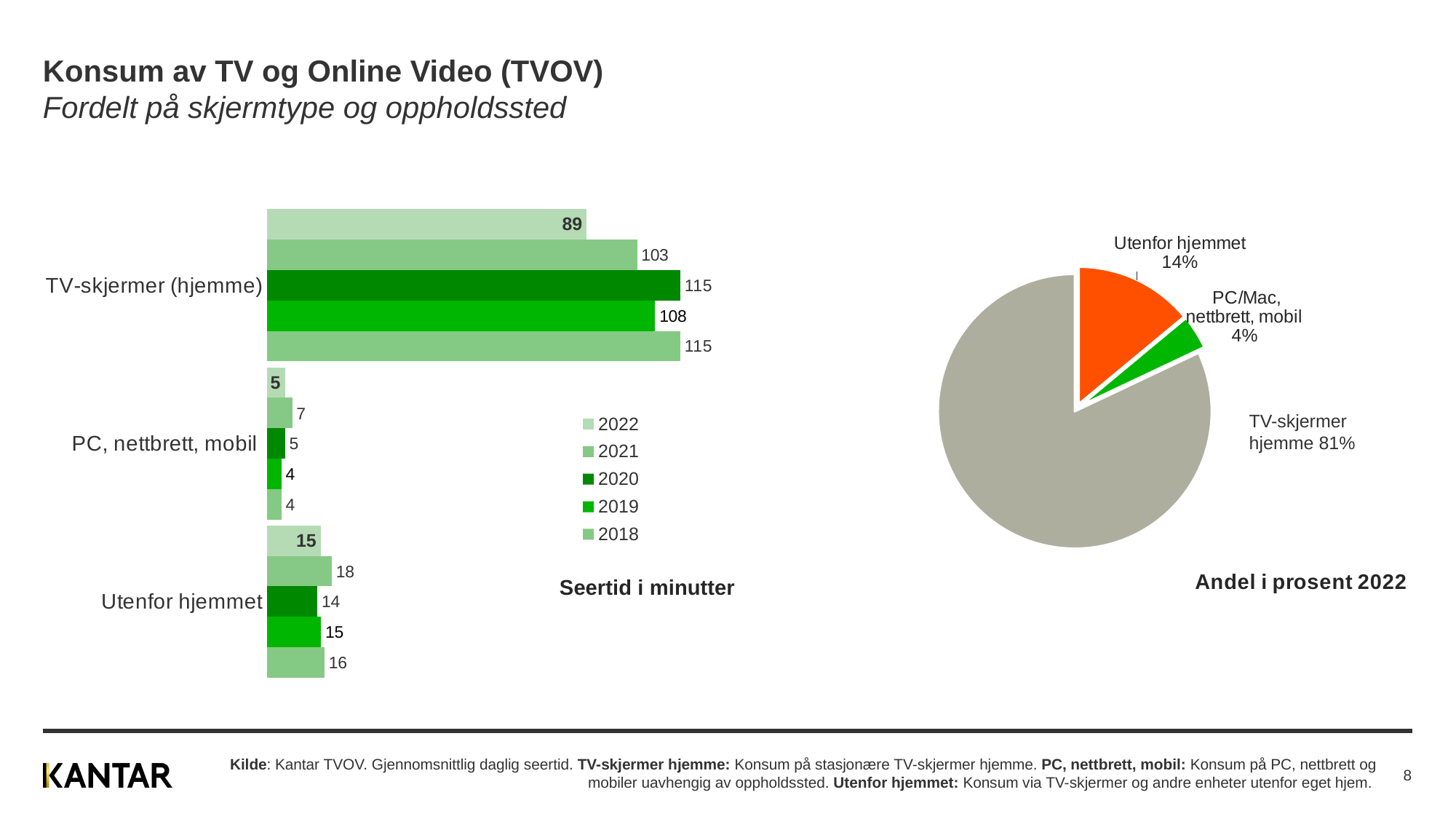
How many categories are shown in the bar chart 'Seertid i minutter'? 3 In the bar chart 'Seertid i minutter', what is the value for PC, nettbrett, mobil in 2019? 4 In the bar chart 'Seertid i minutter', which year has the lowest value for TV-skjermer (hjemme)? 2022 In the bar chart 'Seertid i minutter', which year has the highest value for Utenfor hjemmet? 2021 In the bar chart 'Seertid i minutter', what is the value for Utenfor hjemmet in 2021? 18 How many series does the legend of the bar chart 'Seertid i minutter' list? 5 In the bar chart 'Seertid i minutter', what is the difference between the 2021 and 2022 values for TV-skjermer (hjemme)? 14 In the bar chart 'Seertid i minutter', what is the value for TV-skjermer (hjemme) in 2022? 89 What kind of chart is the chart titled 'Andel i prosent 2022'? Pie chart In the pie chart 'Andel i prosent 2022', what share does Utenfor hjemmet have? 14% In the pie chart 'Andel i prosent 2022', which slice is the largest? TV-skjermer hjemme In the bar chart 'Seertid i minutter', which is larger for TV-skjermer (hjemme): the 2019 value or the 2021 value? 2019